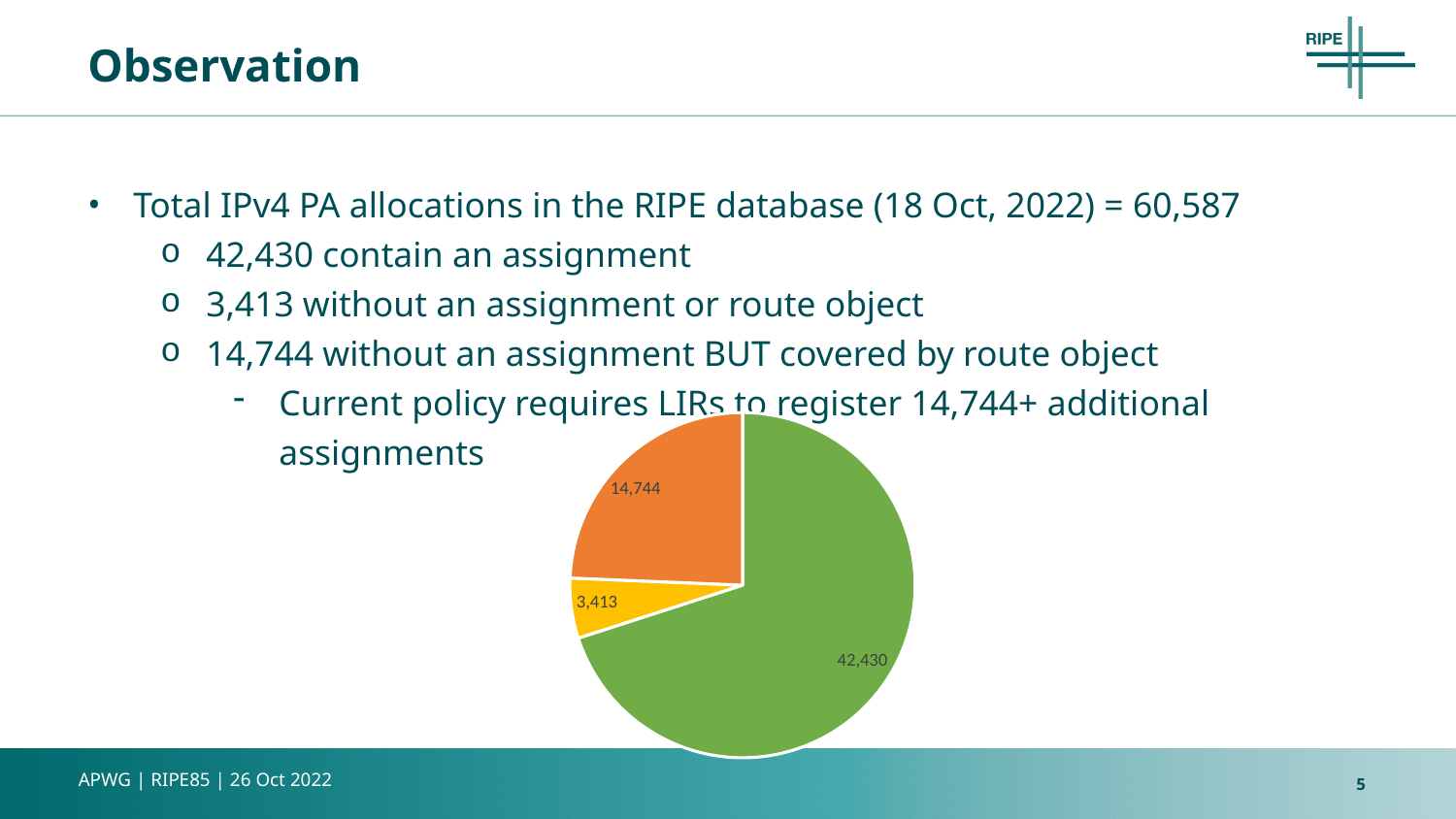
What is the value of the largest slice in the pie chart? 42,430 What value is shown on the orange slice of the pie chart? 14,744 What is the value of the smallest slice in the pie chart? 3,413 What kind of chart is shown on the slide? Pie chart What is the sum of all three slices in the pie chart? 60,587 How many slices does the pie chart have? 3 What colour is the slice representing allocations that contain an assignment (42,430)? Green What value is shown on the yellow slice of the pie chart? 3,413 What value is shown on the green slice of the pie chart? 42,430 What is the difference between the orange slice (14,744) and the yellow slice (3,413) in the pie chart? 11,331 Which slice is larger in the pie chart, the orange slice or the yellow slice? The orange slice (14,744) What is the difference between the green slice (42,430) and the orange slice (14,744) in the pie chart? 27,686